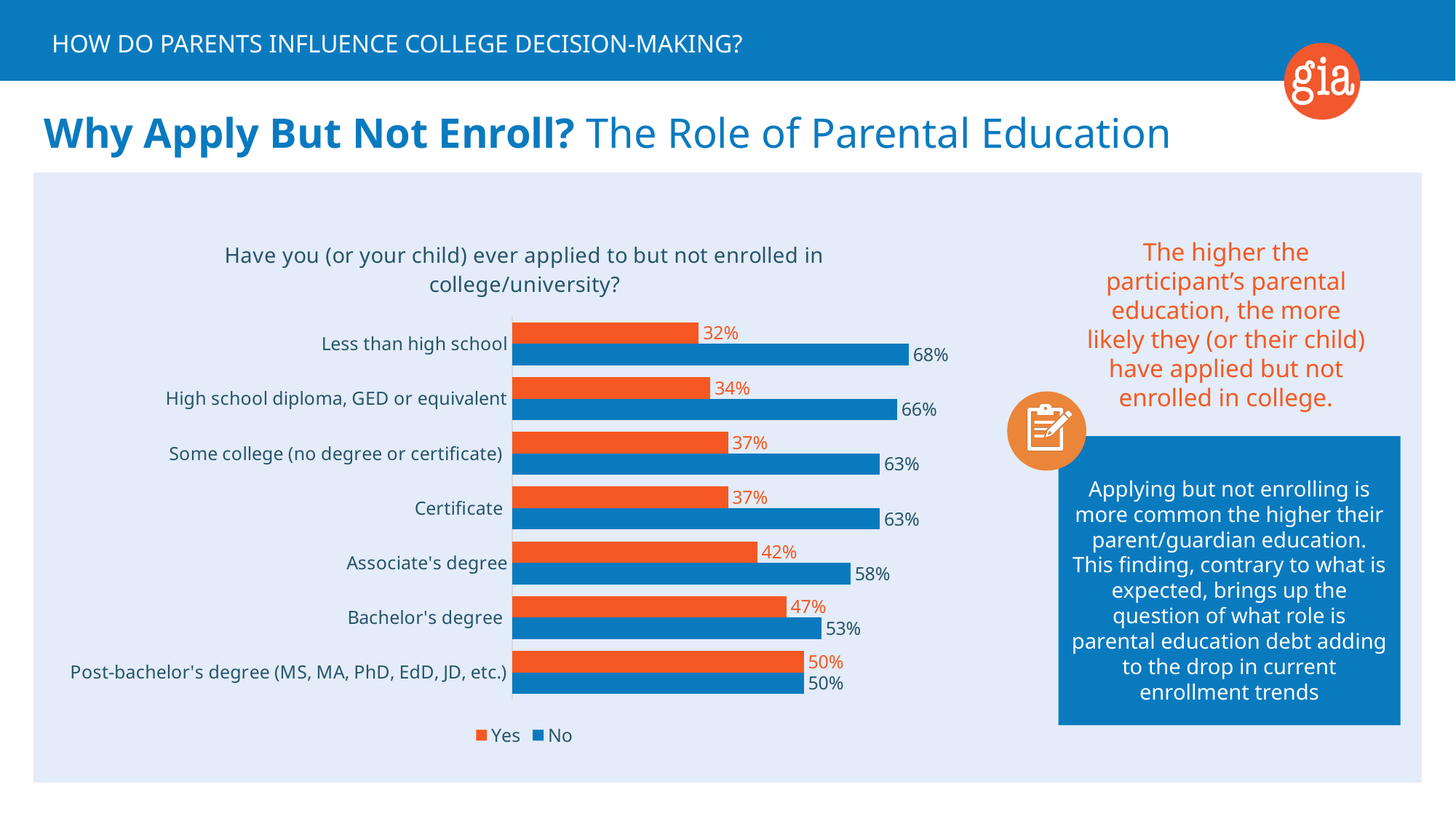
What is the difference between the 'No' and 'Yes' values for Less than high school? 36% What is the 'Yes' value for Bachelor's degree? 47% Which colour represents the 'Yes' series in the chart? Orange Which category has the lowest 'Yes' value? Less than high school Which category has the lowest 'No' value? Post-bachelor's degree (MS, MA, PhD, EdD, JD, etc.) What is the 'No' value for Associate's degree? 58% Which is larger for Associate's degree, the 'Yes' value or the 'No' value? No Which category has the highest 'Yes' value? Post-bachelor's degree (MS, MA, PhD, EdD, JD, etc.) How many series does the legend list? 2 How many parental education categories are shown in the chart? 7 What is the 'Yes' value for Less than high school? 32% What kind of chart is shown on the slide? Bar chart